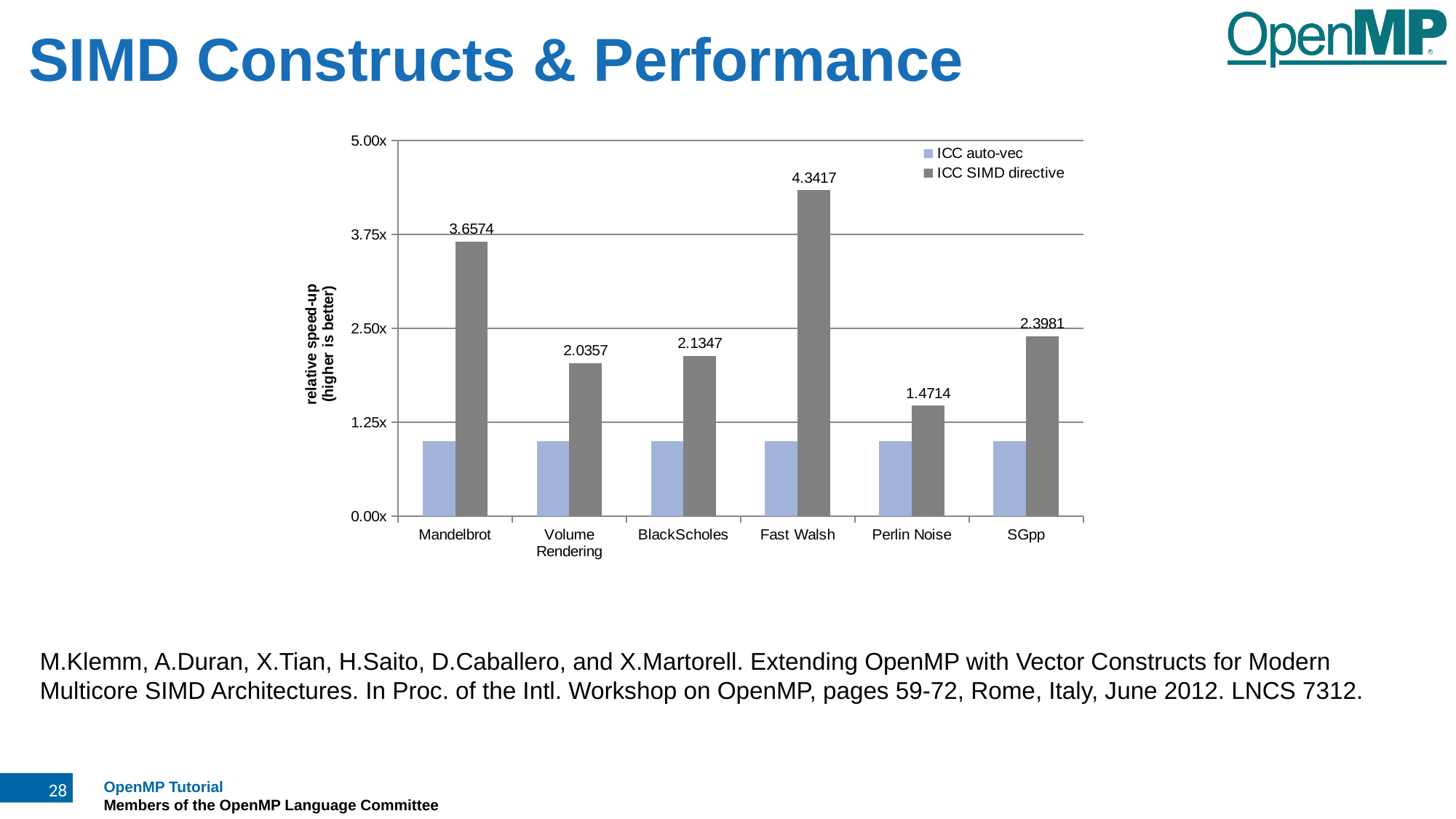
How many benchmarks are shown on the x axis? 6 What is the difference between the ICC SIMD directive speed-ups for Fast Walsh and Mandelbrot? 0.6843 Which benchmark has the lowest ICC SIMD directive speed-up? Perlin Noise Which has the larger ICC SIMD directive speed-up, Volume Rendering or BlackScholes? BlackScholes What is the ICC SIMD directive speed-up for Mandelbrot? 3.6574 What kind of chart is shown on the slide? bar chart What is the ICC SIMD directive speed-up for Perlin Noise? 1.4714 What is the ICC SIMD directive speed-up for Fast Walsh? 4.3417 Is the ICC auto-vec value for Mandelbrot greater or less than 1.25x? less Which benchmark has the highest ICC SIMD directive speed-up? Fast Walsh What is the ICC SIMD directive speed-up for SGpp? 2.3981 How many series does the legend list? 2